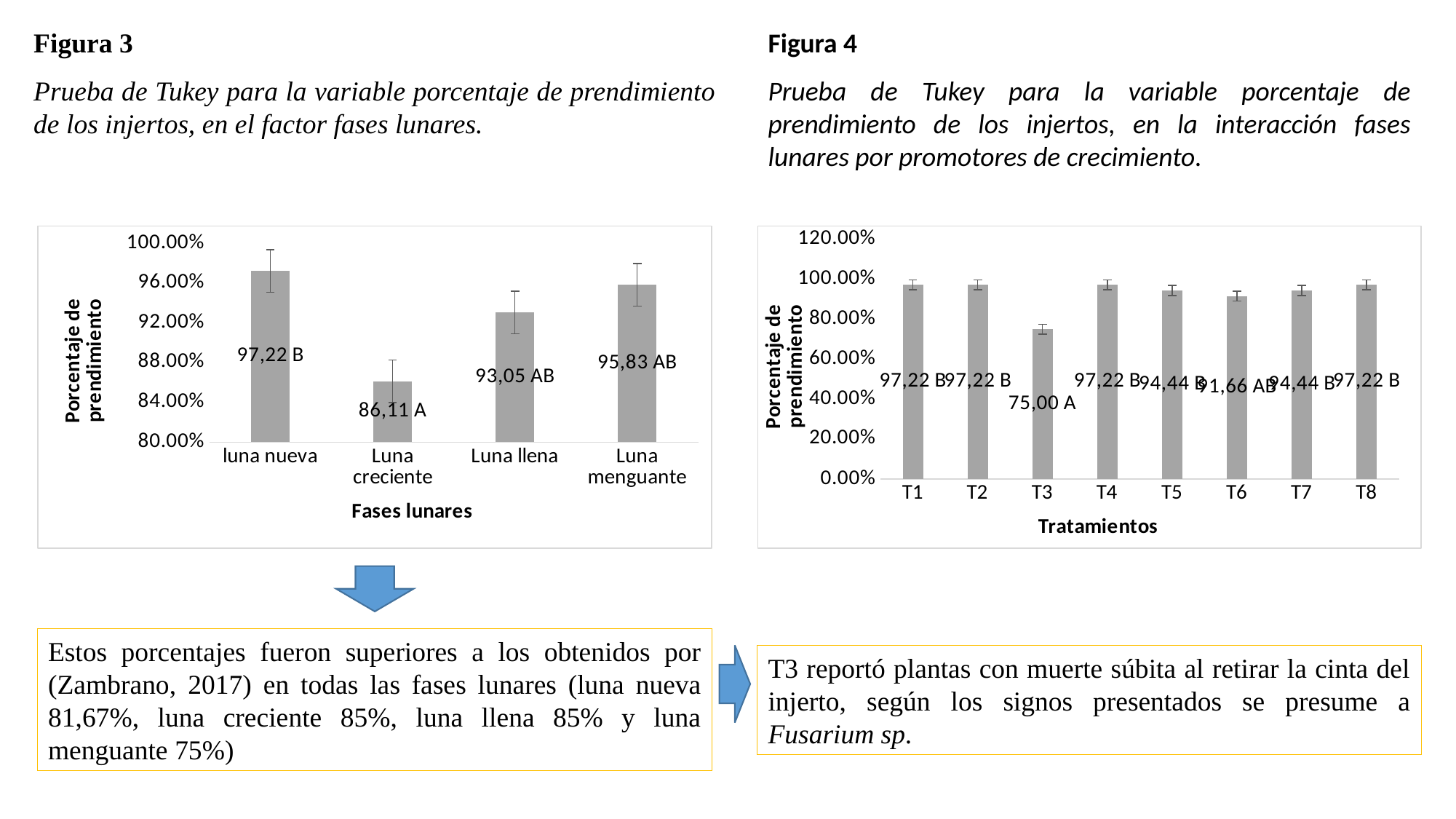
In Figura 4, what is the value shown for T3? 75,00 A In Figura 3, what is the difference between the values for luna nueva and Luna creciente? 11,11 In Figura 3, which lunar phase has the lowest percentage? Luna creciente What kind of chart is Figura 4? Bar chart In Figura 3, what is the value shown for Luna creciente? 86,11 A In Figura 3, what is the value shown for luna nueva? 97,22 B In Figura 4, what is the difference between the values for T1 and T3? 22,22 In Figura 3, how many lunar phases are plotted? 4 In Figura 4, what is the value shown for T6? 91,66 AB In Figura 4, which treatment has the lowest percentage? T3 In Figura 3, which lunar phase has the highest percentage? luna nueva In Figura 4, how many treatments are plotted? 8